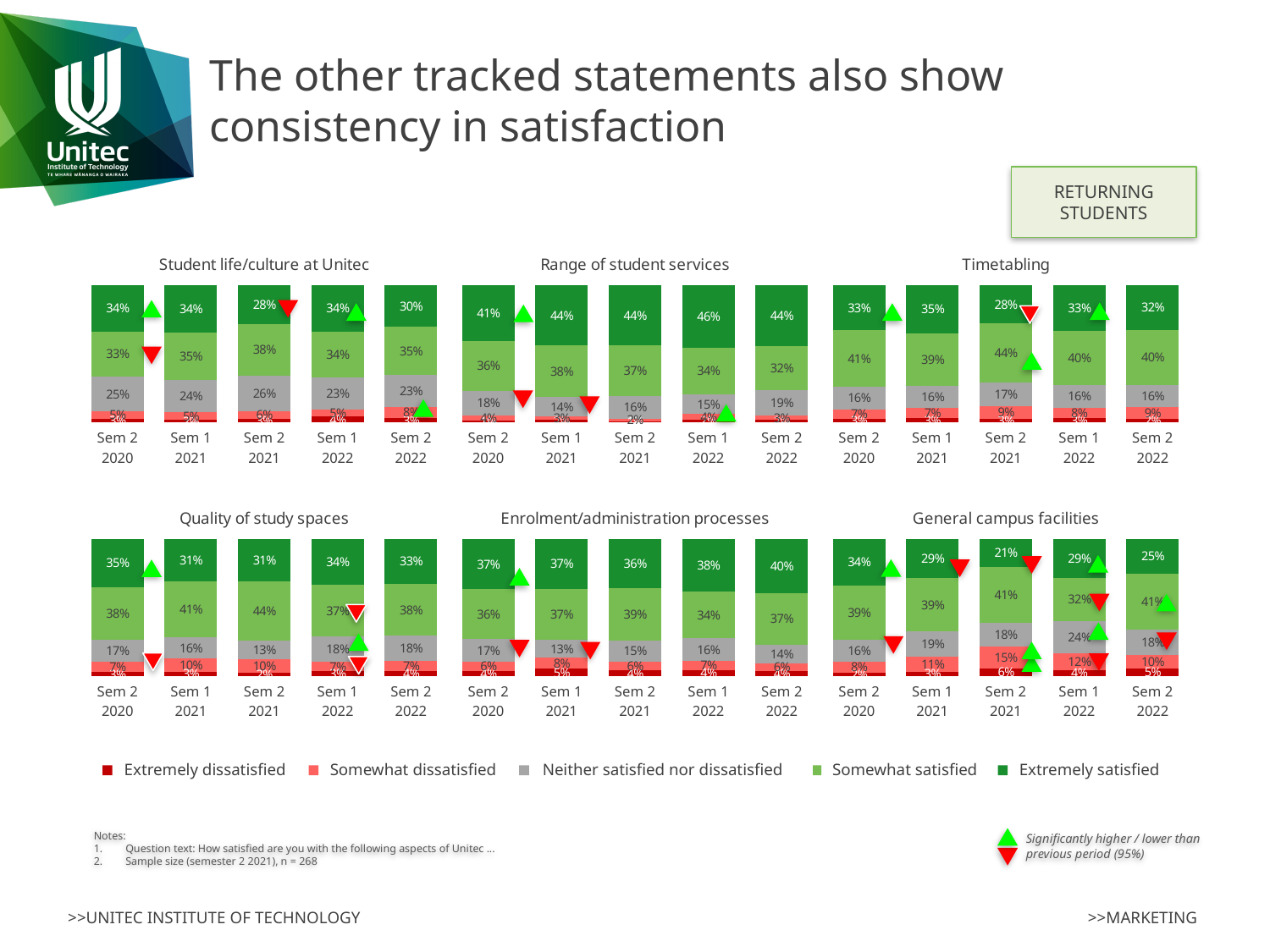
In the 'Quality of study spaces' chart, is the somewhat satisfied percentage higher in Sem 2 2021 or Sem 1 2022? Sem 2 2021 How many periods (bars) are shown in the 'Timetabling' chart? 5 In the 'Enrolment/administration processes' chart, which period has the highest extremely satisfied percentage? Sem 2 2022 In the 'General campus facilities' chart, what is the neither satisfied nor dissatisfied percentage for Sem 1 2022? 24% In the 'Quality of study spaces' chart, what is the somewhat dissatisfied percentage for Sem 1 2021? 10% In the 'Student life/culture at Unitec' chart, what is the difference between the extremely satisfied percentages for Sem 1 2022 and Sem 2 2021? 6% In the 'Timetabling' chart, what is the somewhat satisfied percentage for Sem 2 2021? 44% What type of chart is used for 'Range of student services'? Stacked bar chart Which legend entry is shown in dark green? Extremely satisfied How many series does the legend list? 5 In the 'Range of student services' chart, what percentage of returning students were extremely satisfied in Sem 1 2022? 46% In the 'General campus facilities' chart, which period has the lowest extremely satisfied percentage? Sem 2 2021